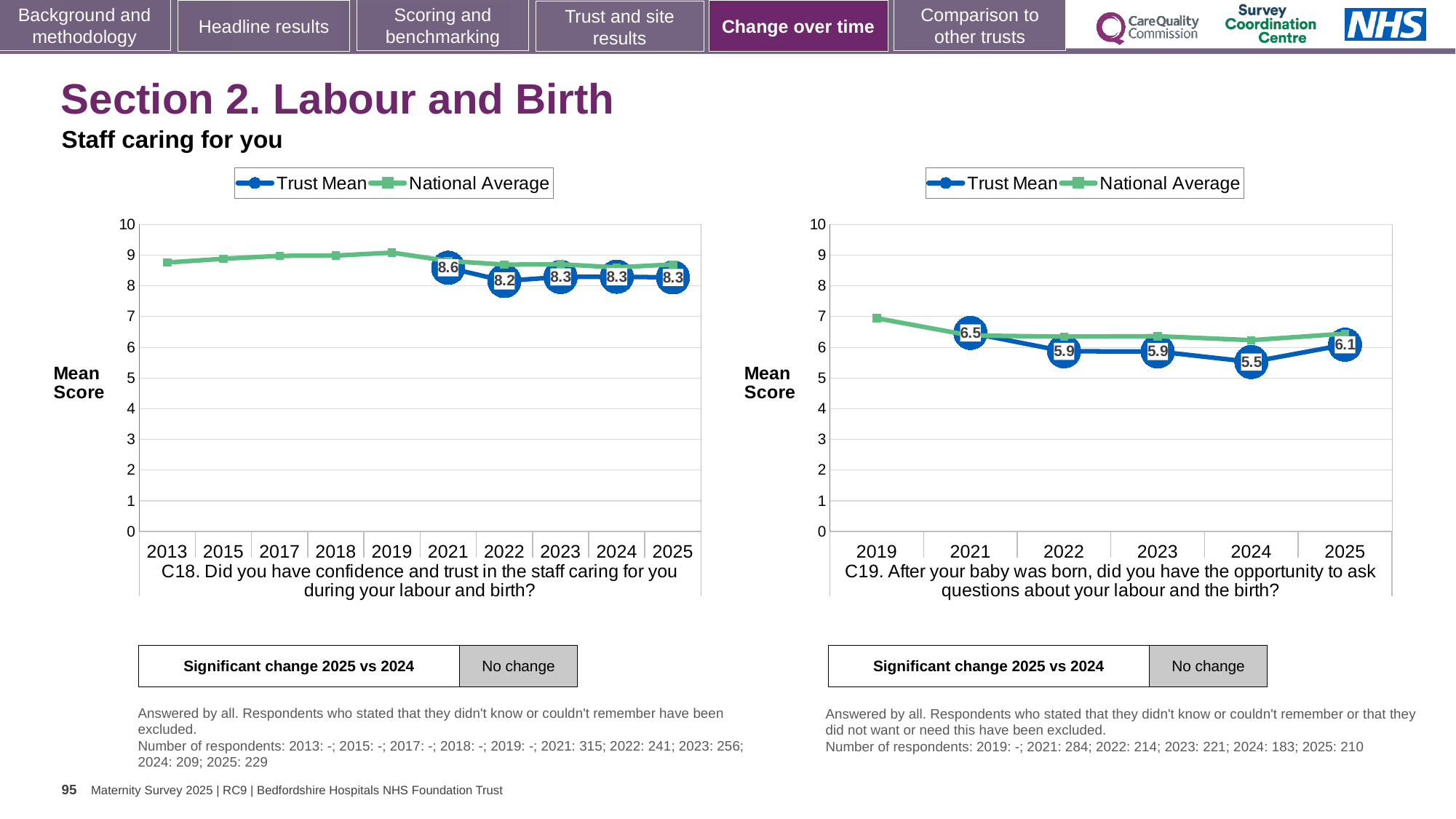
In the C18 chart on the left, what is the difference between the Trust Mean values for 2021 and 2022? 0.4 How many years are shown on the x axis of the C18 chart on the left? 10 In the C19 chart on the right, what is the Trust Mean value for 2025? 6.1 In the C18 chart on the left, what is the Trust Mean value for 2021? 8.6 In the C19 chart on the right, which year has the lowest labelled Trust Mean value? 2024 In the C19 chart on the right, is the Trust Mean value for 2021 or 2024 larger? 2021 In the C19 chart on the right, what is the difference between the Trust Mean values for 2025 and 2024? 0.6 How many series does the legend of the C19 chart on the right list? 2 In the C19 chart on the right, what is the Trust Mean value for 2024? 5.5 In the C19 chart on the right, which year has the highest labelled Trust Mean value? 2021 In the C18 chart on the left, what is the Trust Mean value for 2022? 8.2 In the C18 chart on the left, is the National Average value for 2019 greater or less than 8? greater